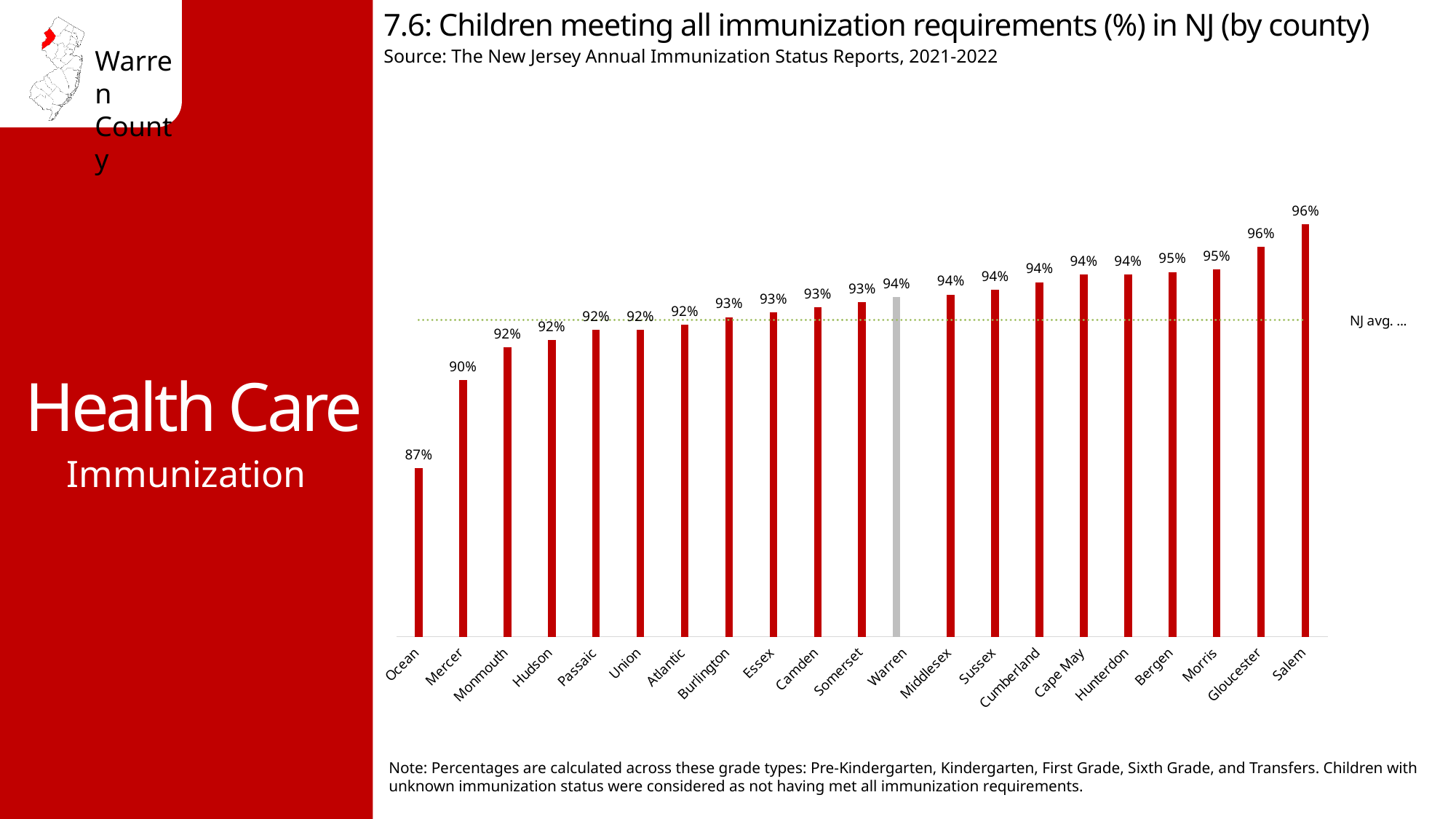
What is the difference in percentage points between Salem and Ocean counties? 9 percentage points What percentage of children meet all immunization requirements in Warren County? 94% What kind of chart is shown on the slide? Bar chart What is the difference in percentage points between Warren and Ocean counties? 7 percentage points What is the value shown for Salem County? 96% Do the values rise or fall from left to right along the x axis? Rise Which has a higher value, Warren or Mercer? Warren What is the value shown for Ocean County? 87% Which county has the lowest percentage of children meeting all immunization requirements? Ocean What is the value shown for Mercer County? 90% What is the value shown for Bergen County? 95% How many counties are shown in the chart? 21